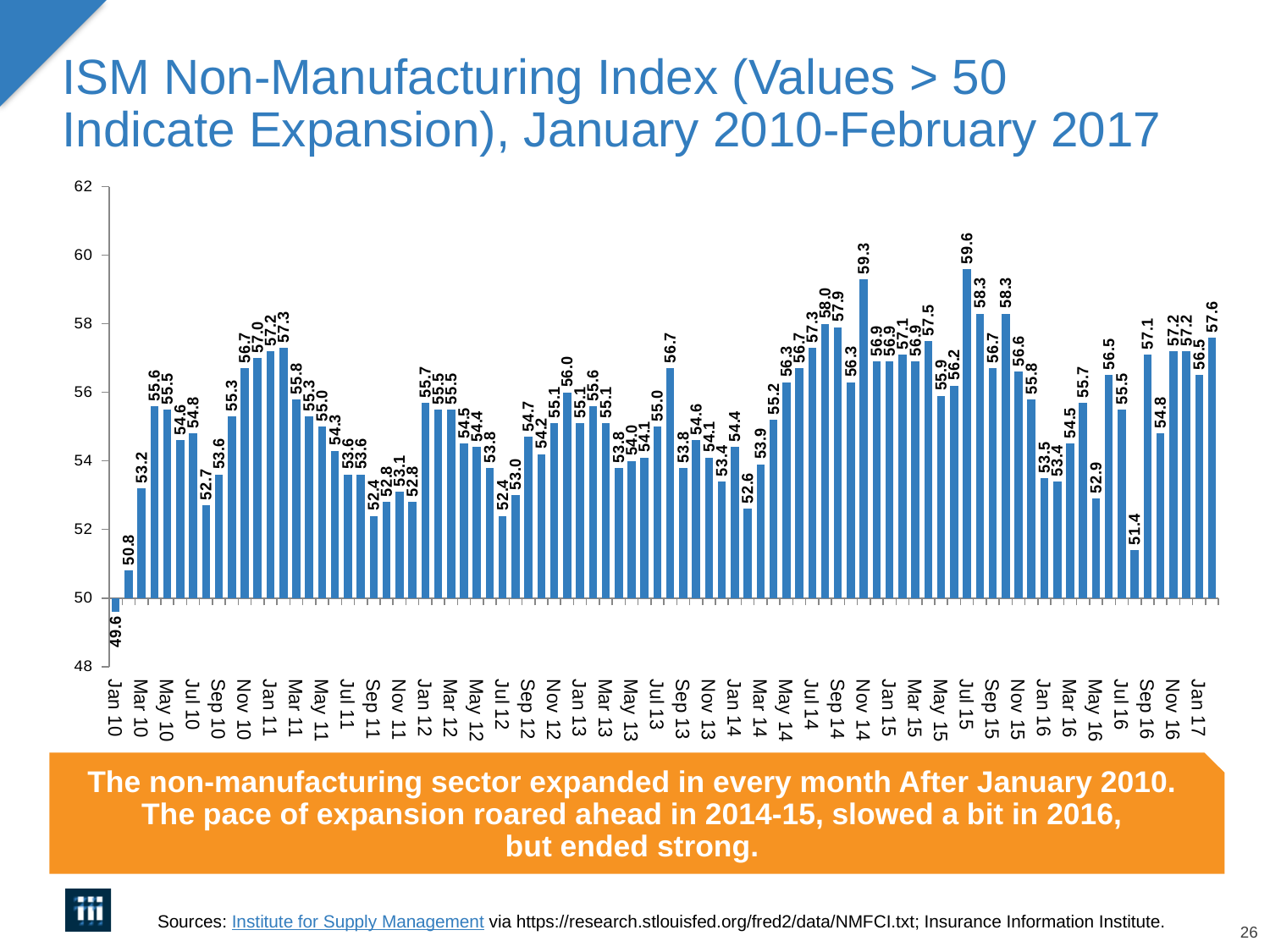
Is the value for Jan 10 greater or less than 50? less What is the ISM Non-Manufacturing Index value for Nov 14? 59.3 Which month has the highest ISM Non-Manufacturing Index value in the chart? Jul 15 What is the value of the last bar in the chart (February 2017)? 57.6 Do the values rise or fall from May 14 to Jul 14? rise Which month has the lowest ISM Non-Manufacturing Index value in the chart? Jan 10 What is the difference between the highest value (Jul 15) and the lowest value (Jan 10)? 10.0 What is the ISM Non-Manufacturing Index value for Jan 10? 49.6 What is the lowest index value shown for any month after January 2010? 51.4 What kind of chart is shown on the slide? bar chart Which is larger, the value for Jul 15 or the value for Nov 14? Jul 15 What is the title of the chart? ISM Non-Manufacturing Index (Values > 50 Indicate Expansion), January 2010-February 2017